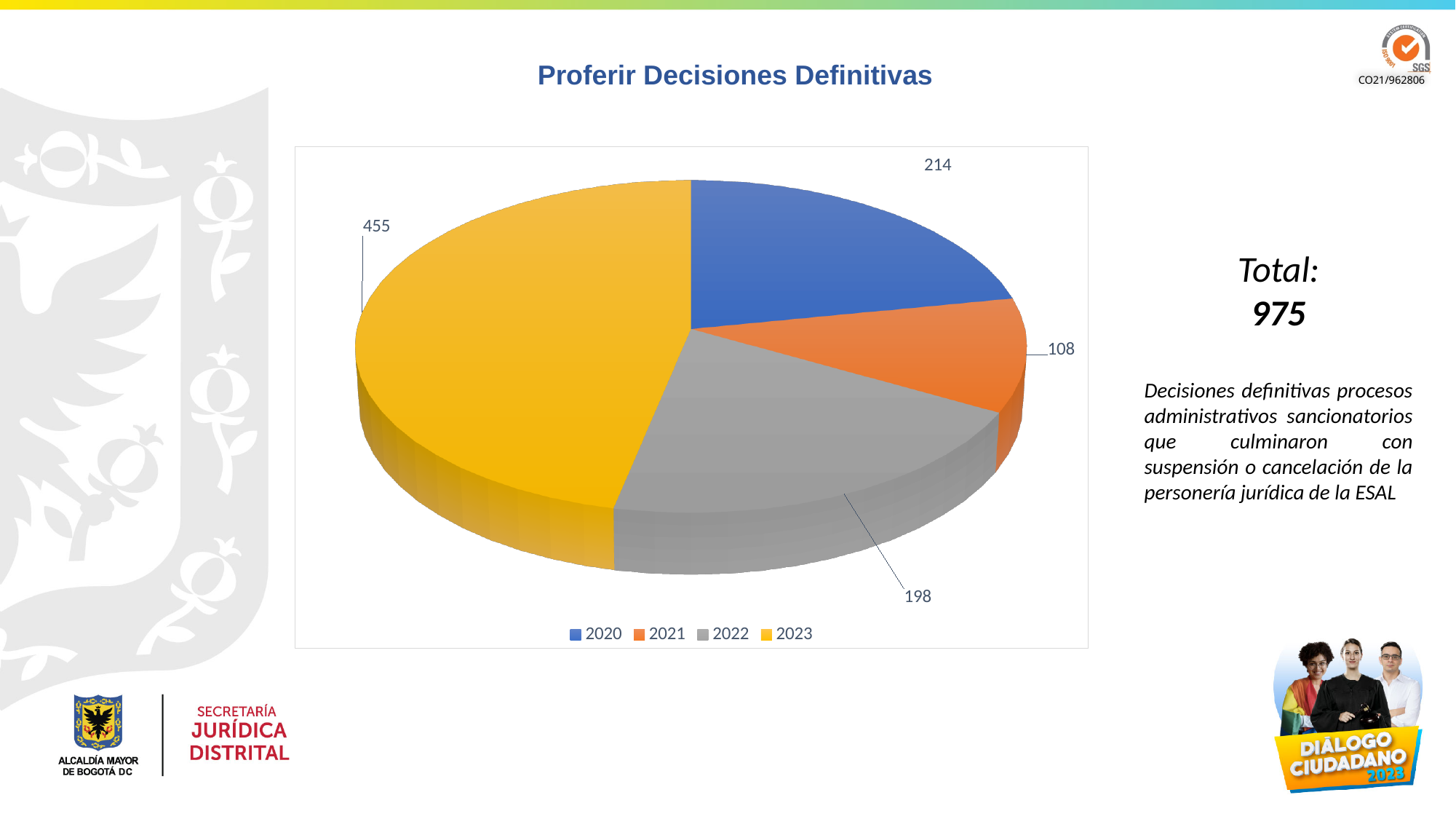
What is the difference between the values for 2023 and 2020? 241 What is the total of all the slices in the pie chart? 975 Which is larger, the value for 2020 or the value for 2022? 2020 What is the title of the chart on the slide? Proferir Decisiones Definitivas Which year has the largest slice in the pie chart? 2023 What is the value for 2022 in the pie chart? 198 How many slices does the pie chart have? 4 What is the value for 2020 in the pie chart? 214 Which year has the smallest slice in the pie chart? 2021 What type of chart is shown on the slide? pie chart What is the value for 2021 in the pie chart? 108 What is the value for 2023 in the pie chart? 455